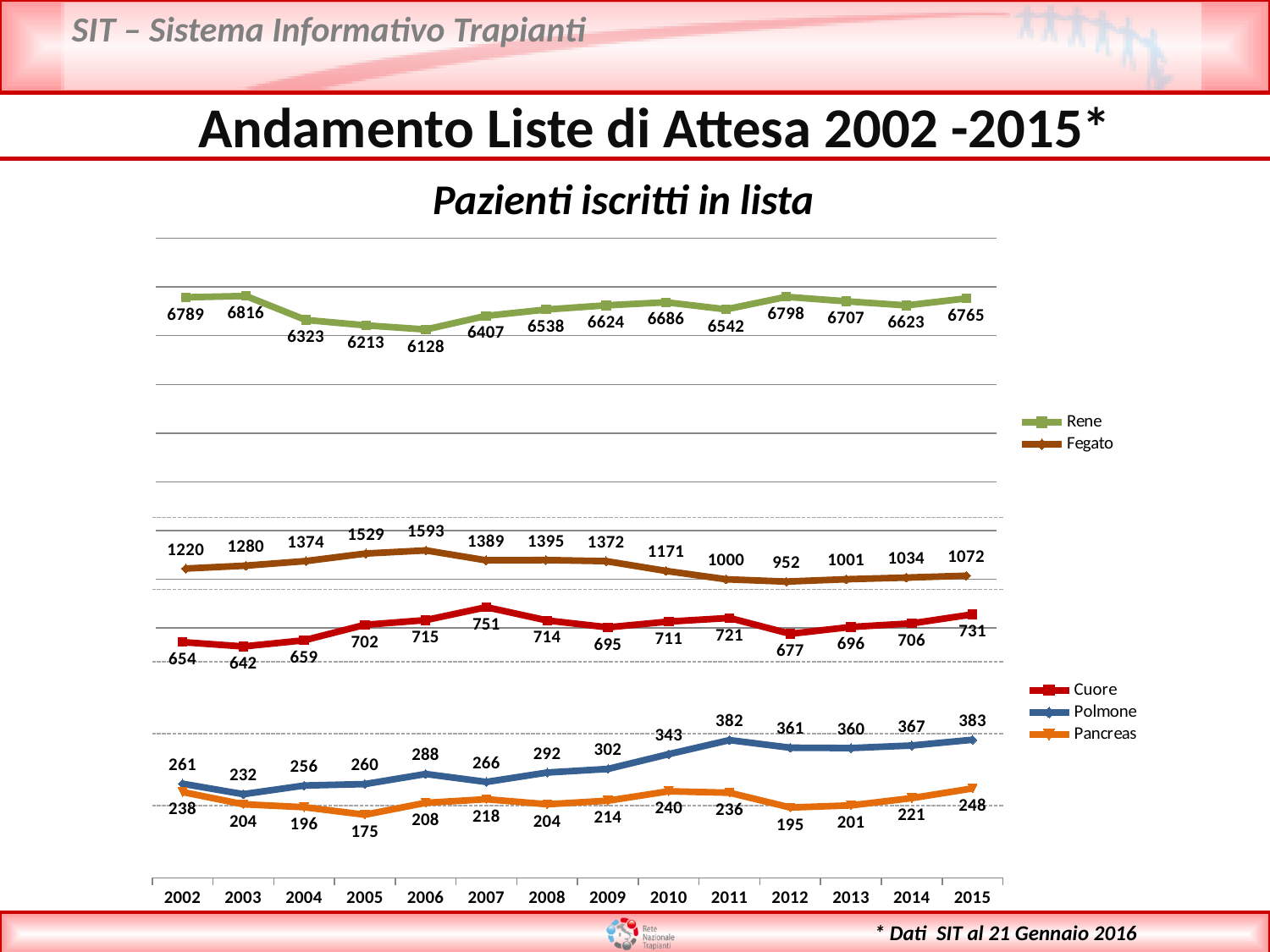
In which year does the Pancreas series reach its lowest value? 2005 What is the value for Fegato in 2011? 1000 In which year does the Fegato series reach its highest value? 2006 What is the difference between the Rene value in 2003 and the Rene value in 2002? 27 What is the title of the chart? Pazienti iscritti in lista How many years are shown on the x axis? 14 What is the value for Rene in 2006? 6128 Which is larger for Cuore: the value in 2007 or the value in 2015? 2007 What kind of chart is shown on the slide? line chart How many data series are plotted on the chart? 5 What is the value for Polmone in 2011? 382 Does the Polmone series rise or fall overall from 2002 to 2015? rise